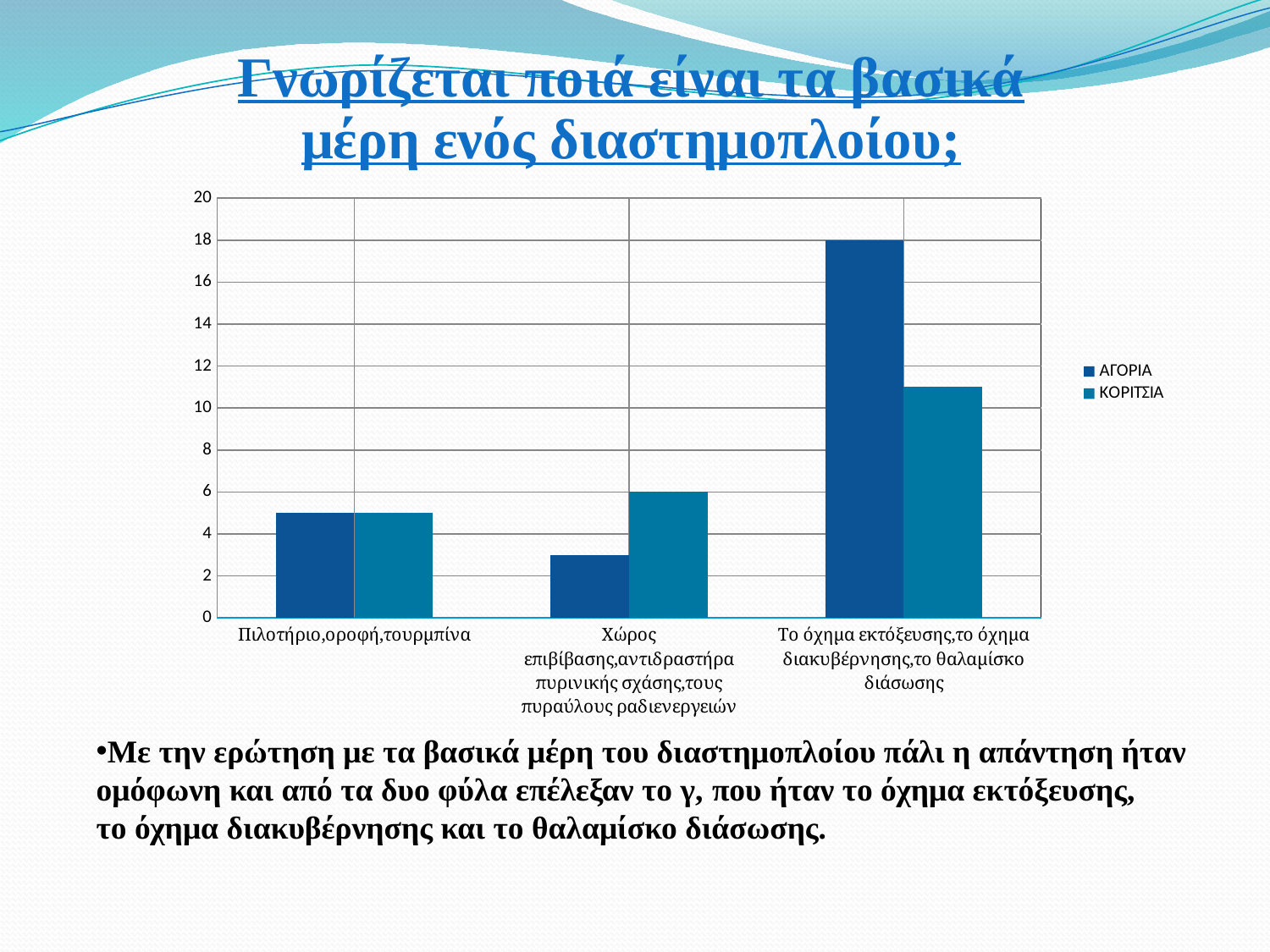
Which series is shown in the darker blue colour in the legend? ΑΓΟΡΙΑ How many categories are shown on the x axis? 3 What is the value for ΚΟΡΙΤΣΙΑ in the category 'Χώρος επιβίβασης,αντιδραστήρα πυρινικής σχάσης,τους πυραύλους ραδιενεργειών'? 6 Which category has the highest value for ΑΓΟΡΙΑ? Το όχημα εκτόξευσης,το όχημα διακυβέρνησης,το θαλαμίσκο διάσωσης Which category has the lowest value for ΑΓΟΡΙΑ? Χώρος επιβίβασης,αντιδραστήρα πυρινικής σχάσης,τους πυραύλους ραδιενεργειών Which category has the lowest value for ΚΟΡΙΤΣΙΑ? Πιλοτήριο,οροφή,τουρμπίνα In the category 'Το όχημα εκτόξευσης,το όχημα διακυβέρνησης,το θαλαμίσκο διάσωσης', which series has the larger value, ΑΓΟΡΙΑ or ΚΟΡΙΤΣΙΑ? ΑΓΟΡΙΑ What type of chart is shown on the slide? bar chart Is the value for ΑΓΟΡΙΑ in the category 'Χώρος επιβίβασης,αντιδραστήρα πυρινικής σχάσης,τους πυραύλους ραδιενεργειών' greater or less than 4? less Is the value for ΚΟΡΙΤΣΙΑ in the category 'Το όχημα εκτόξευσης,το όχημα διακυβέρνησης,το θαλαμίσκο διάσωσης' greater or less than 10? greater How many series does the legend list? 2 What is the value for ΑΓΟΡΙΑ in the category 'Το όχημα εκτόξευσης,το όχημα διακυβέρνησης,το θαλαμίσκο διάσωσης'? 18